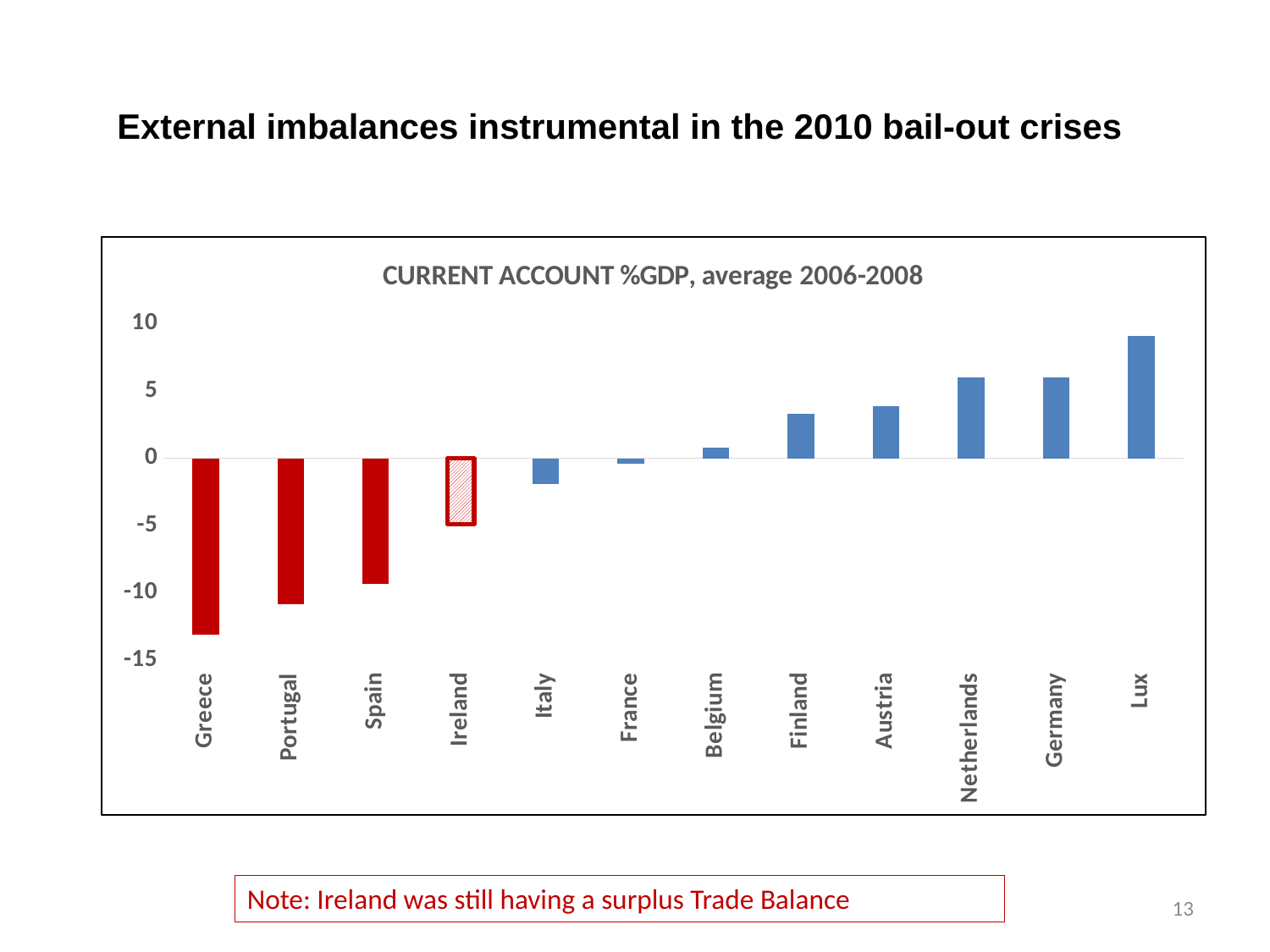
Which has the larger current account value, Portugal or Spain? Spain Is the value for Italy greater or less than -5? greater How many countries are shown on the x axis of the chart? 12 Which country has the highest current account value in the chart? Lux Do the values generally rise or fall moving from left to right along the x axis? rise Is the value for Lux greater or less than 5? greater Which country has the lowest current account value in the chart? Greece What kind of chart is shown on the slide? bar chart Is the value for Finland greater or less than 5? less What is the title of the chart? CURRENT ACCOUNT %GDP, average 2006-2008 Which country's bar is drawn with a hatched pattern rather than a solid fill? Ireland